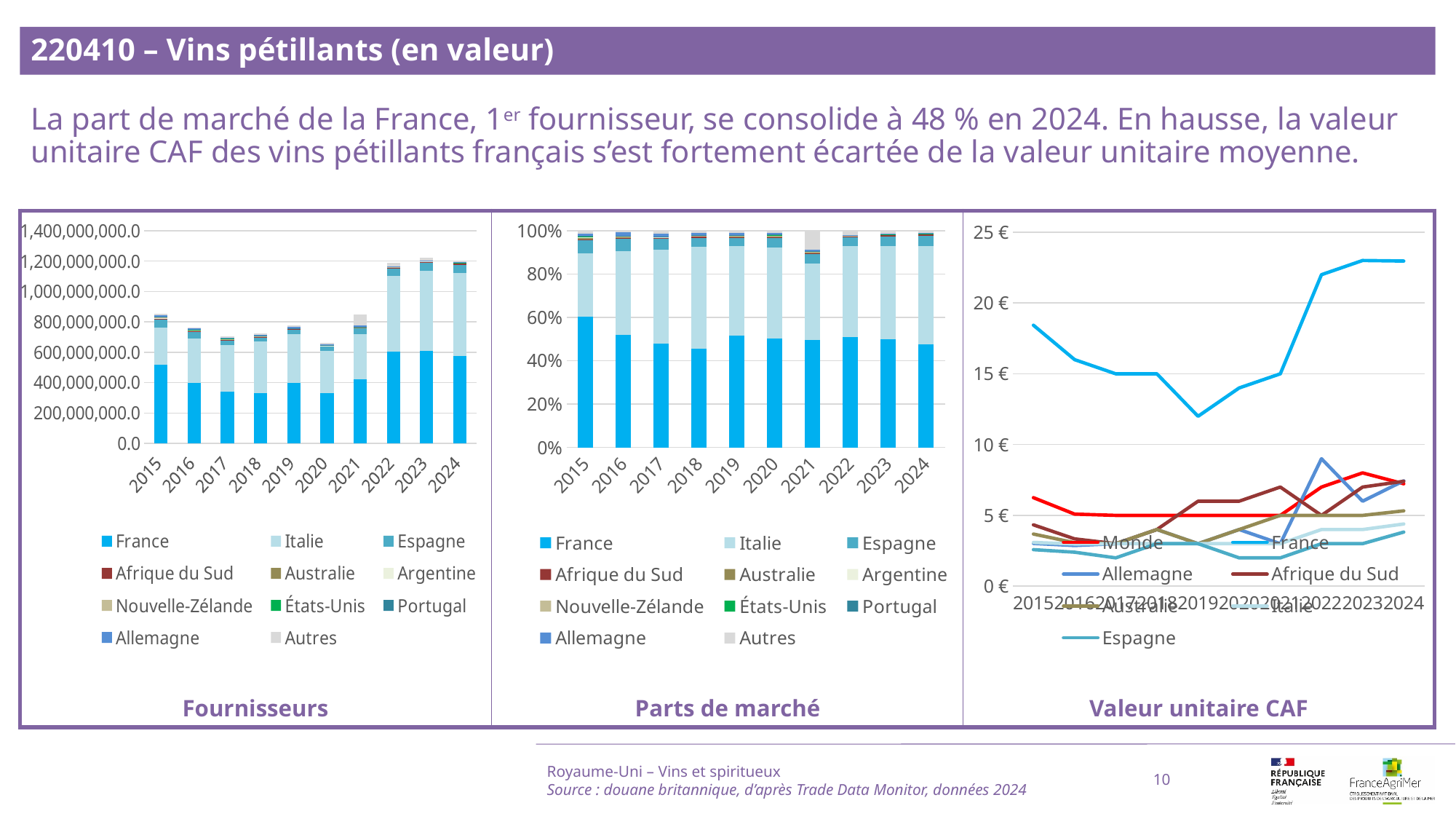
What kind of chart is the 'Valeur unitaire CAF' chart? line chart How many years are shown on the x axis of the 'Fournisseurs' chart? 10 What kind of chart is the 'Fournisseurs' chart? stacked bar chart In the 'Fournisseurs' chart, which year has the lowest total bar? 2020 In the 'Parts de marché' chart, which year has the highest share for France? 2015 In the 'Fournisseurs' chart, is the France value for 2024 greater or less than 400,000,000.0? greater How many series does the legend of the 'Parts de marché' chart list? 11 In the 'Valeur unitaire CAF' chart, does the France line rise or fall between 2019 and 2024? rise In the 'Valeur unitaire CAF' chart, which series has the highest value in 2024? France In the 'Fournisseurs' chart, is the total value for 2022 greater or less than 1,000,000,000.0? greater In the 'Parts de marché' chart, is the France share for 2018 greater or less than 50%? less How many series does the legend of the 'Valeur unitaire CAF' chart list? 7